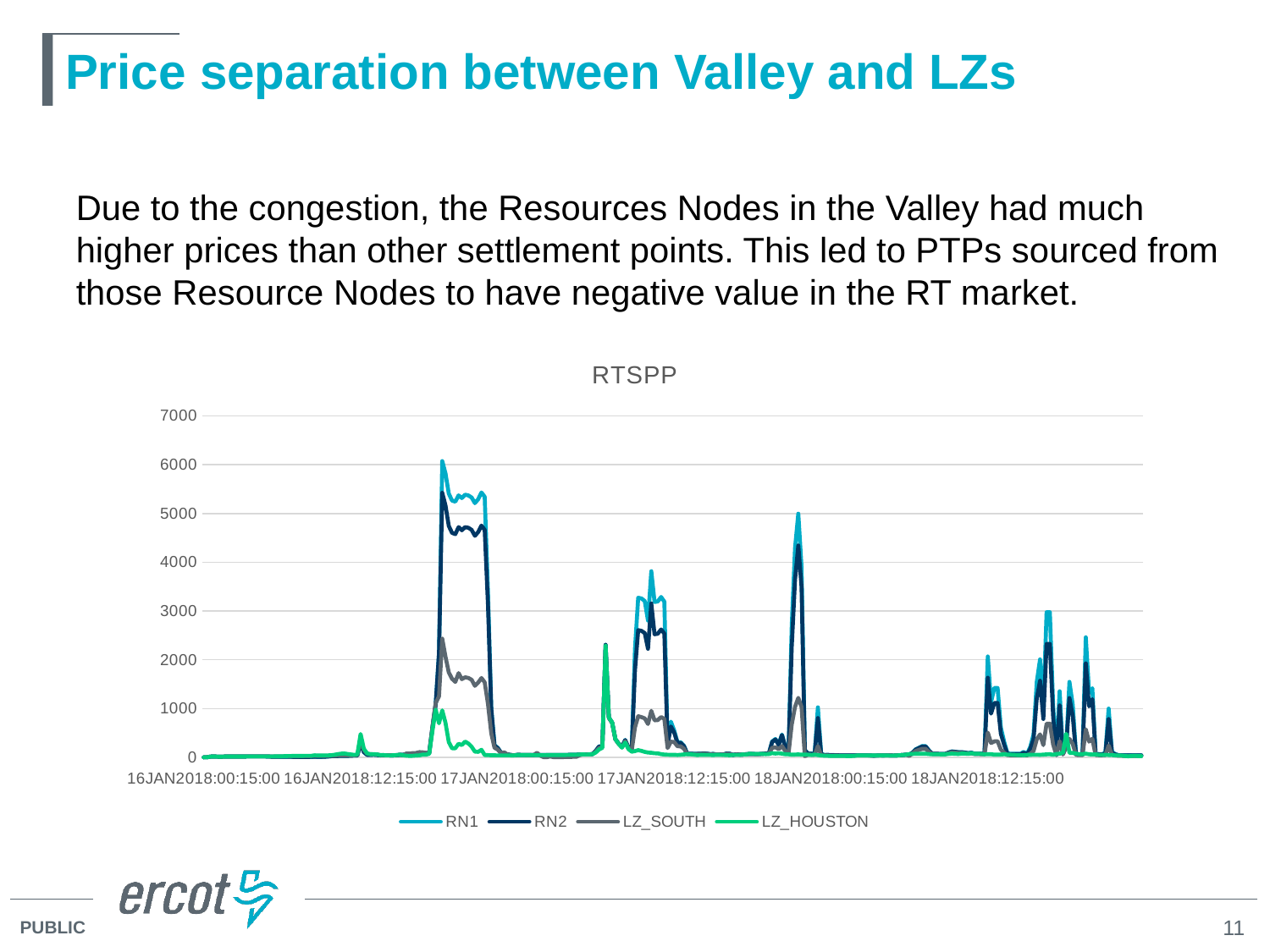
How many series does the legend of the RTSPP chart list? 4 Which series are listed in the legend of the RTSPP chart? RN1, RN2, LZ_SOUTH, LZ_HOUSTON Which series reaches the highest value on the RTSPP chart? RN1 Is the highest peak of LZ_HOUSTON on the RTSPP chart greater or less than 3000? less Is the highest peak of RN1 on the RTSPP chart greater or less than 5000? greater What kind of chart is shown on the slide? line chart Is the highest peak of RN2 on the RTSPP chart greater or less than 4000? greater How many time labels are shown on the x axis of the RTSPP chart? 6 What is the highest value shown on the y axis of the RTSPP chart? 7000 Which series reaches a higher peak on the RTSPP chart, RN1 or LZ_HOUSTON? RN1 What is the title of the chart on the slide? RTSPP